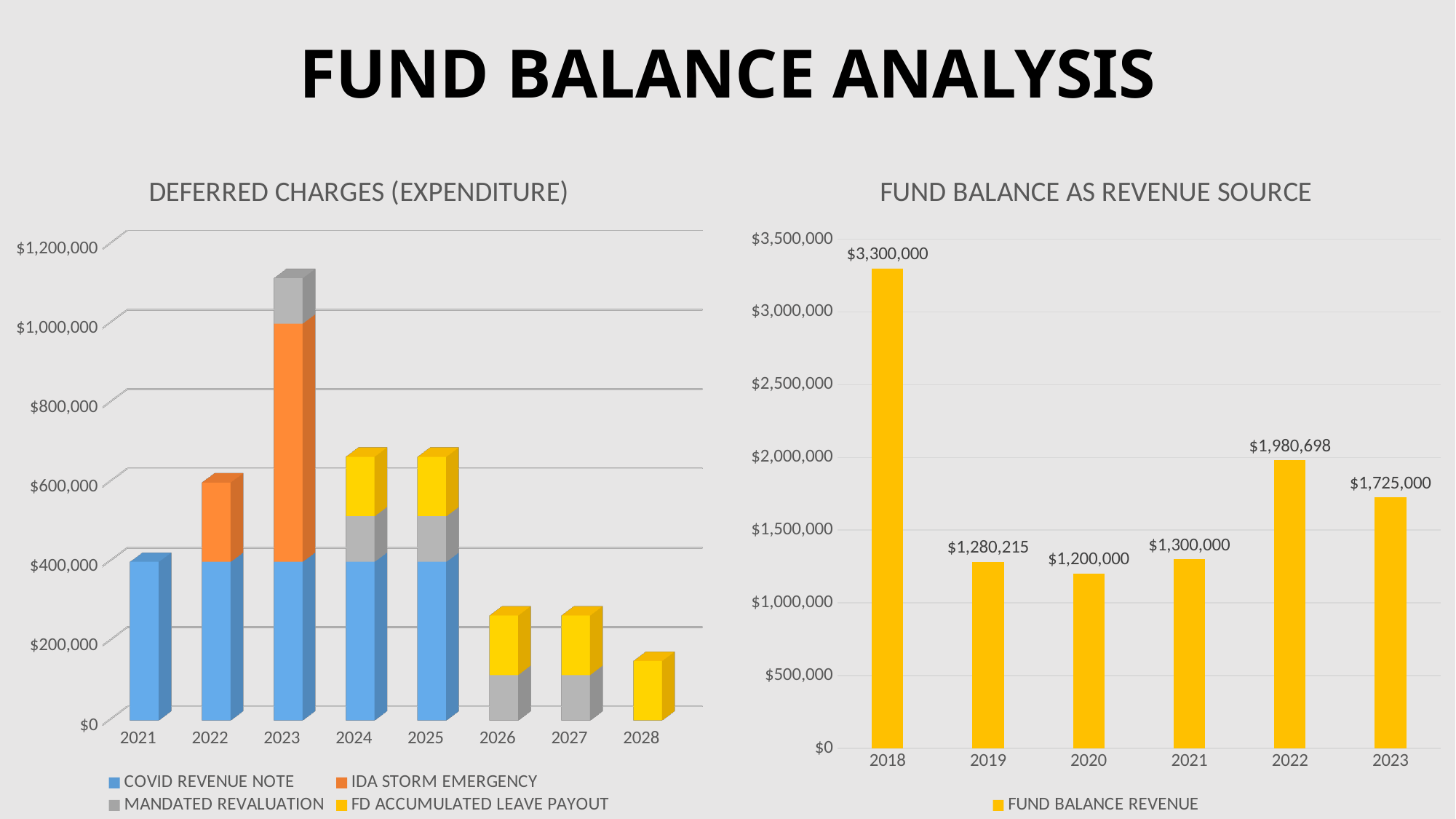
In the DEFERRED CHARGES (EXPENDITURE) chart, which year has the highest total deferred charges? 2023 How many years are shown in the FUND BALANCE AS REVENUE SOURCE chart? 6 In the FUND BALANCE AS REVENUE SOURCE chart, how much larger is the 2022 value than the 2023 value? $255,698 What kind of chart is the DEFERRED CHARGES (EXPENDITURE) chart? Stacked bar chart In the FUND BALANCE AS REVENUE SOURCE chart, which year has the highest fund balance revenue? 2018 How many series does the legend of the DEFERRED CHARGES (EXPENDITURE) chart list? 4 In the DEFERRED CHARGES (EXPENDITURE) chart, is the total for 2023 greater or less than $1,000,000? greater In the FUND BALANCE AS REVENUE SOURCE chart, which is larger, the value for 2019 or the value for 2021? 2021 In the FUND BALANCE AS REVENUE SOURCE chart, what is the value for 2022? $1,980,698 In the FUND BALANCE AS REVENUE SOURCE chart, what is the difference between the 2021 and 2020 values? $100,000 In the FUND BALANCE AS REVENUE SOURCE chart, which year has the lowest fund balance revenue? 2020 In the FUND BALANCE AS REVENUE SOURCE chart, what is the fund balance revenue for 2018? $3,300,000